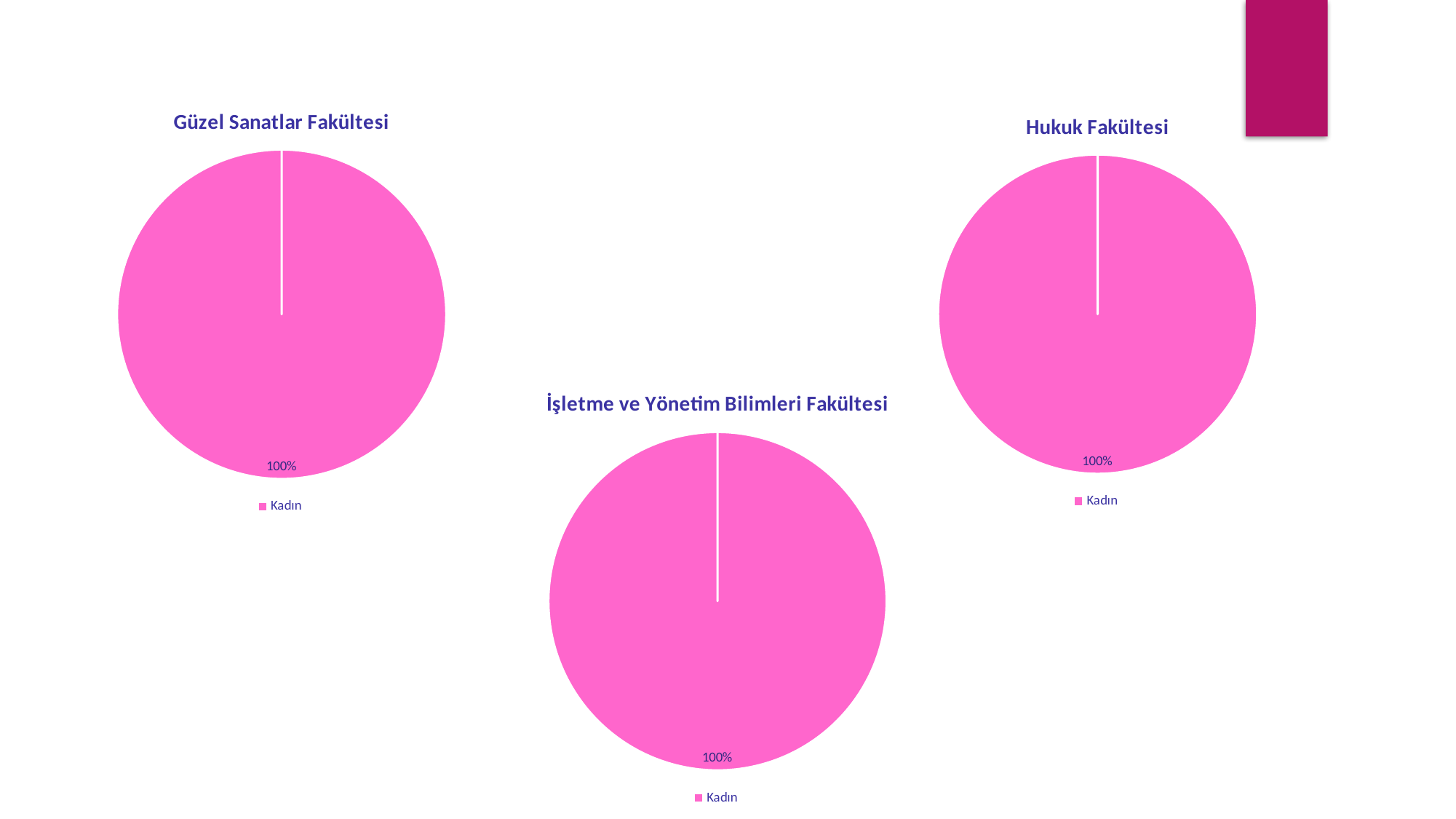
What is the title of the chart in the middle of the slide? İşletme ve Yönetim Bilimleri Fakültesi What kind of chart is the 'Güzel Sanatlar Fakültesi' chart? Pie chart How many pie charts are shown on the slide? 3 In the 'Güzel Sanatlar Fakültesi' chart, what share does the Kadın slice have? 100% How many entries does the legend of the 'Hukuk Fakültesi' chart list? 1 How many entries does the legend of the 'Güzel Sanatlar Fakültesi' chart list? 1 How many slices does the 'İşletme ve Yönetim Bilimleri Fakültesi' pie chart have? 1 What is the legend entry in the 'İşletme ve Yönetim Bilimleri Fakültesi' chart? Kadın In the 'İşletme ve Yönetim Bilimleri Fakültesi' chart, what share does the Kadın slice have? 100% What kind of chart is the 'Hukuk Fakültesi' chart? Pie chart In the 'Hukuk Fakültesi' chart, what share does the Kadın slice have? 100%